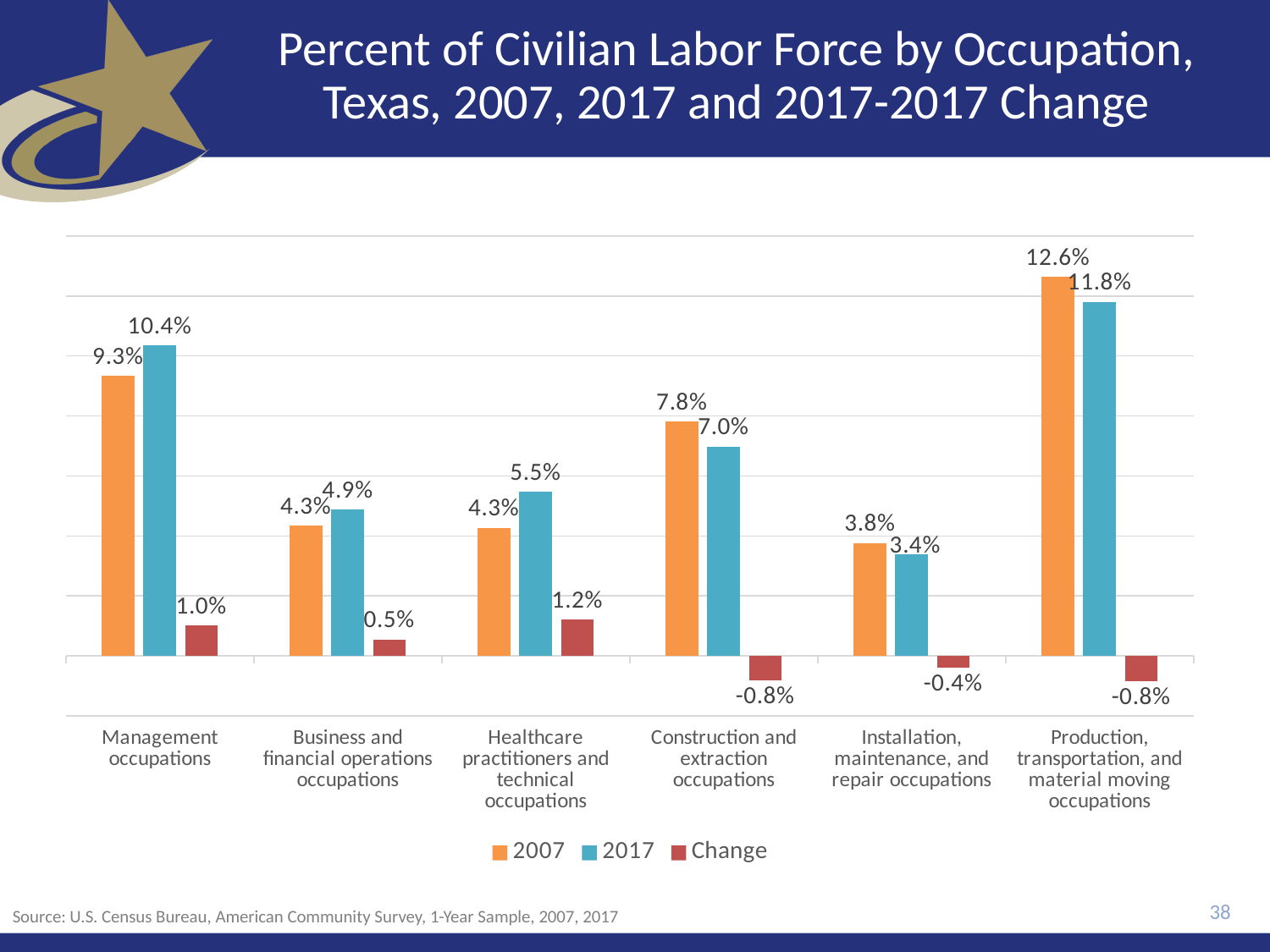
What is the Change value for Healthcare practitioners and technical occupations? 1.2% What was the 2017 value for Management occupations? 10.4% What was the 2017 value for Installation, maintenance, and repair occupations? 3.4% How many series does the legend list? 3 What kind of chart is shown on the slide? Bar chart How many occupation categories are shown on the chart? 6 What was the 2007 value for Construction and extraction occupations? 7.8% Which series is shown in orange in the legend? 2007 Which occupation has the highest 2007 value? Production, transportation, and material moving occupations What is the difference between the 2017 and 2007 values for Business and financial operations occupations? 0.6% Which occupation has the lowest 2017 value? Installation, maintenance, and repair occupations Which is larger for Construction and extraction occupations, the 2007 value or the 2017 value? 2007